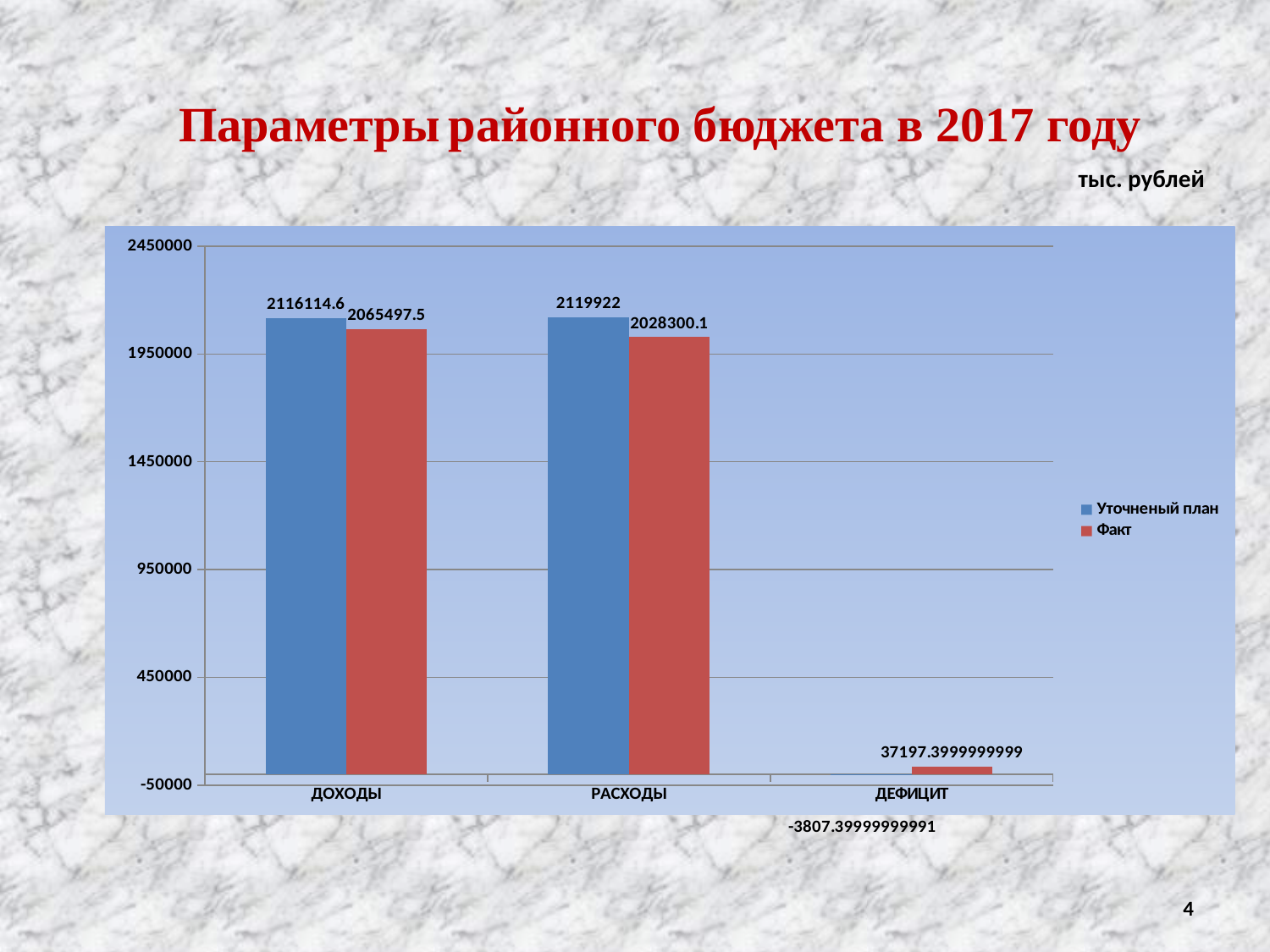
How many categories are shown on the x axis? 3 Which category has the lowest Факт value? ДЕФИЦИТ What is the value of Факт for ДОХОДЫ? 2065497.5 What is the value of Факт for ДЕФИЦИТ? 37197.3999999999 What is the value of Уточненый план for ДОХОДЫ? 2116114.6 What is the difference between Уточненый план and Факт for ДОХОДЫ? 50617.1 What is the value of Факт for РАСХОДЫ? 2028300.1 What is the value of Уточненый план for РАСХОДЫ? 2119922 Which is larger for РАСХОДЫ, Уточненый план or Факт? Уточненый план What is the value of Уточненый план for ДЕФИЦИТ? -3807.39999999991 What is the difference between Уточненый план and Факт for РАСХОДЫ? 91621.9 How many series does the legend list? 2